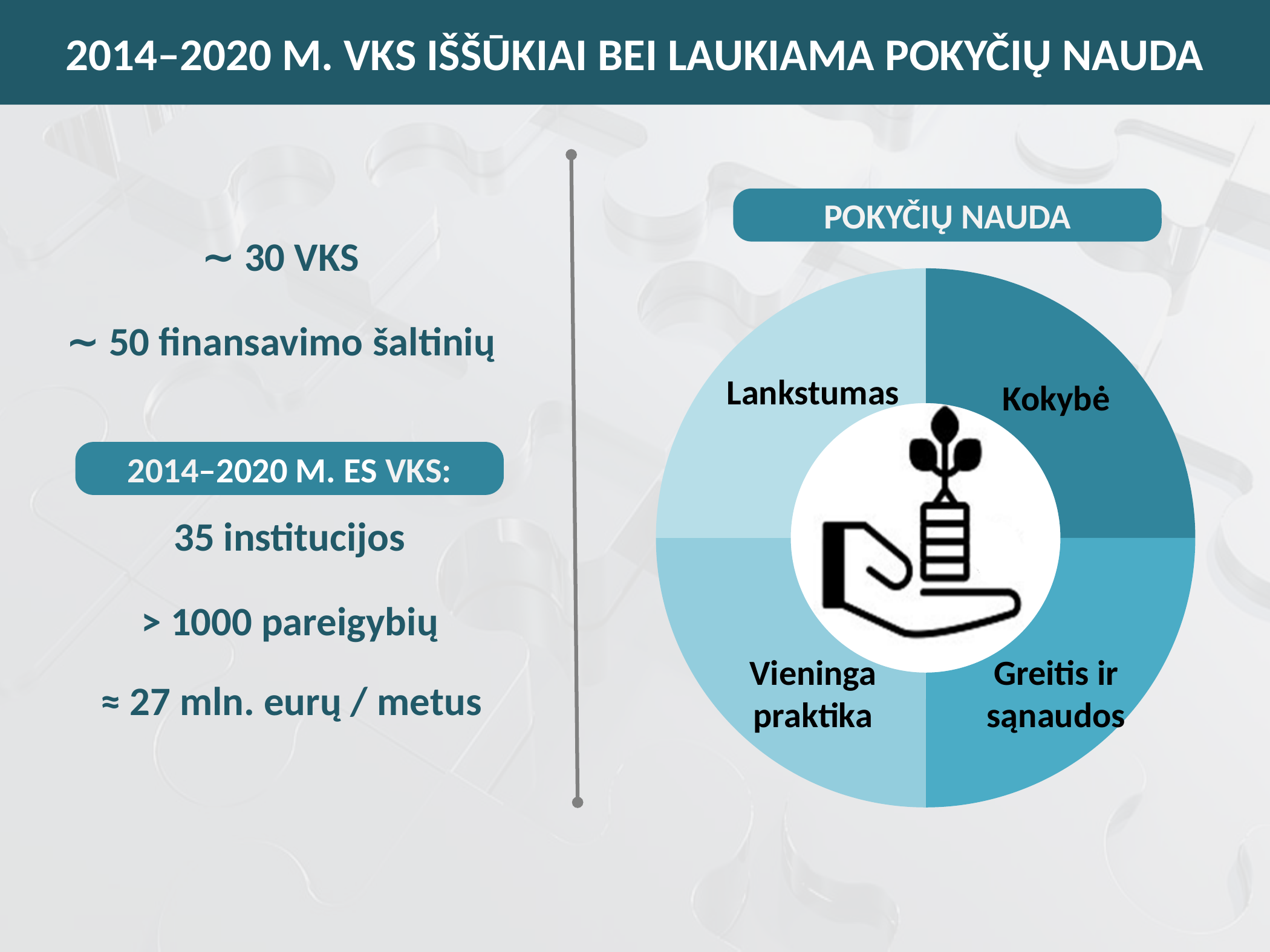
Which label appears in the top-left segment of the circular diagram? Lankstumas Which label appears in the top-right segment of the circular diagram? Kokybė Which label appears in the bottom-left segment of the circular diagram? Vieninga praktika Which segment of the circular diagram is the darkest shade of blue? Kokybė How many segments does the circular diagram under "POKYČIŲ NAUDA" have? 4 Which label appears in the bottom-right segment of the circular diagram? Greitis ir sąnaudos What is the title shown above the circular diagram on the right side of the slide? POKYČIŲ NAUDA